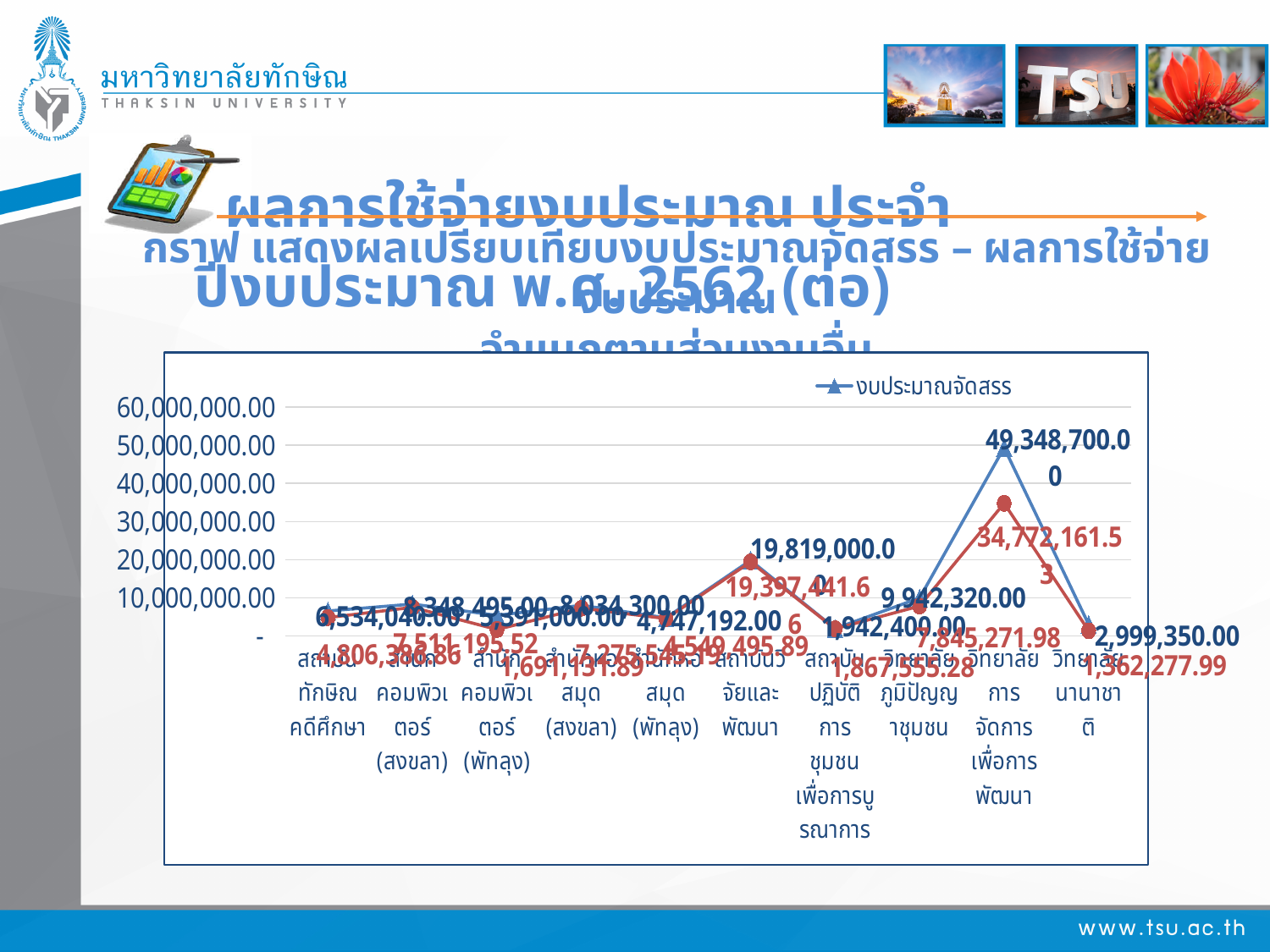
What is the difference between the งบประมาณจัดสรร value and the red-line value for วิทยาลัยการจัดการเพื่อการพัฒนา? 14,576,538.47 For วิทยาลัยภูมิปัญญาชุมชน, which is larger: the งบประมาณจัดสรร value or the red-line value? งบประมาณจัดสรร What is the งบประมาณจัดสรร value for วิทยาลัยการจัดการเพื่อการพัฒนา? 49,348,700.00 Which unit has the lowest งบประมาณจัดสรร value in the chart? สถาบันปฏิบัติการชุมชนเพื่อการบูรณาการ What is the value of the red line for วิทยาลัยการจัดการเพื่อการพัฒนา? 34,772,161.53 What is the งบประมาณจัดสรร value for สถาบันวิจัยและพัฒนา? 19,819,000.00 Which unit has the highest งบประมาณจัดสรร value in the chart? วิทยาลัยการจัดการเพื่อการพัฒนา How many units (categories) are plotted along the x axis of the chart? 10 What is the value of the red line for วิทยาลัยนานาชาติ? 1,362,277.99 What kind of chart is shown on the slide? line chart Is the งบประมาณจัดสรร value for วิทยาลัยการจัดการเพื่อการพัฒนา greater or less than 40,000,000.00? greater What is the งบประมาณจัดสรร value for วิทยาลัยนานาชาติ? 2,999,350.00